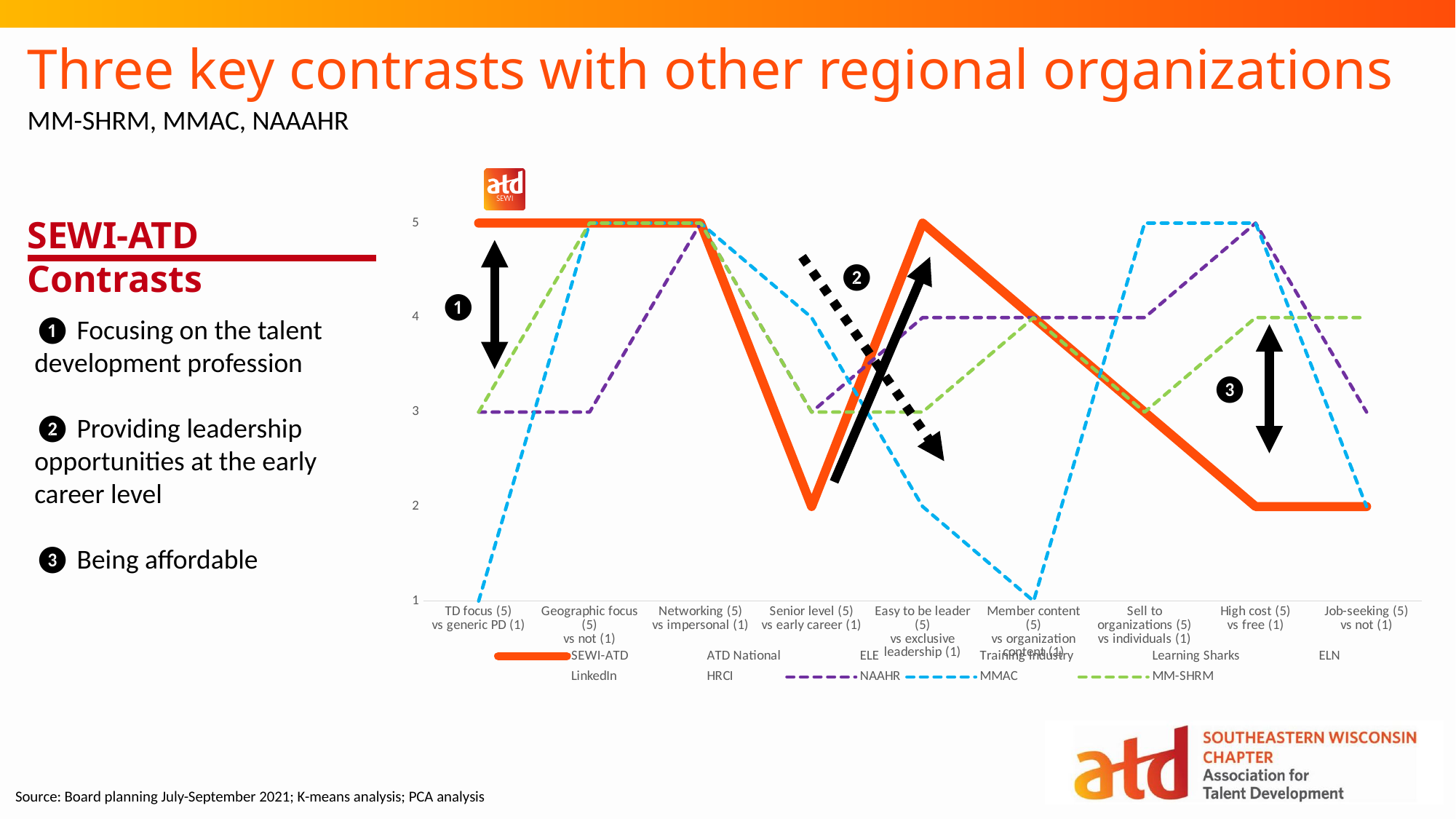
What is the value for MM-SHRM at 'Job-seeking (5) vs not (1)'? 4 How many categories are shown along the x axis of the chart? 9 What colour is the SEWI-ATD line in the chart? orange What kind of chart is shown on the slide? line chart At 'Senior level (5) vs early career (1)', which is larger: SEWI-ATD or MMAC? MMAC What is the value for NAAHR at 'High cost (5) vs free (1)'? 5 What is the value for MMAC at 'TD focus (5) vs generic PD (1)'? 1 Does the SEWI-ATD line rise or fall from 'Easy to be leader' to 'High cost'? fall What is the value for SEWI-ATD at 'High cost (5) vs free (1)'? 2 What is the difference between SEWI-ATD and MMAC at 'Easy to be leader (5) vs exclusive leadership (1)'? 3 What is the value for SEWI-ATD at 'Senior level (5) vs early career (1)'? 2 Is the value for SEWI-ATD at 'Member content (5) vs organization content (1)' greater or less than 3? greater